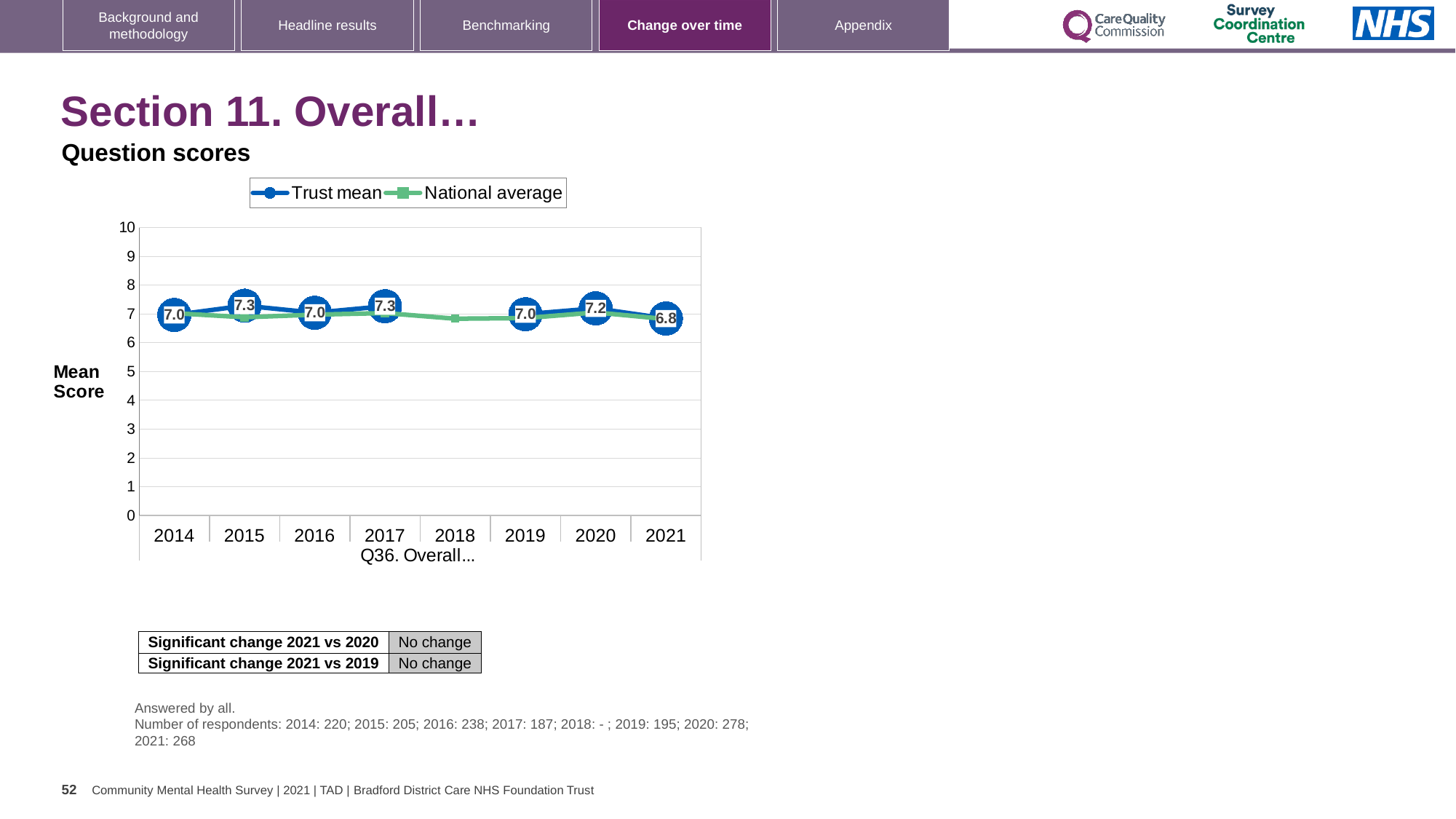
What is the difference between the Trust mean scores for 2020 and 2021? 0.4 What is the Trust mean score for 2014? 7.0 How many series does the chart legend list? 2 Is the National average value for 2014 greater or less than 6? greater What is the Trust mean score for 2021? 6.8 How many years are shown on the x axis of the chart? 8 What is the Trust mean score for 2015? 7.3 Does the Trust mean score rise or fall from 2020 to 2021? Fall In which year is the Trust mean score lowest? 2021 Which is larger, the Trust mean score for 2017 or for 2021? 2017 What kind of chart is shown on the slide? Line chart What is the Trust mean score for 2020? 7.2